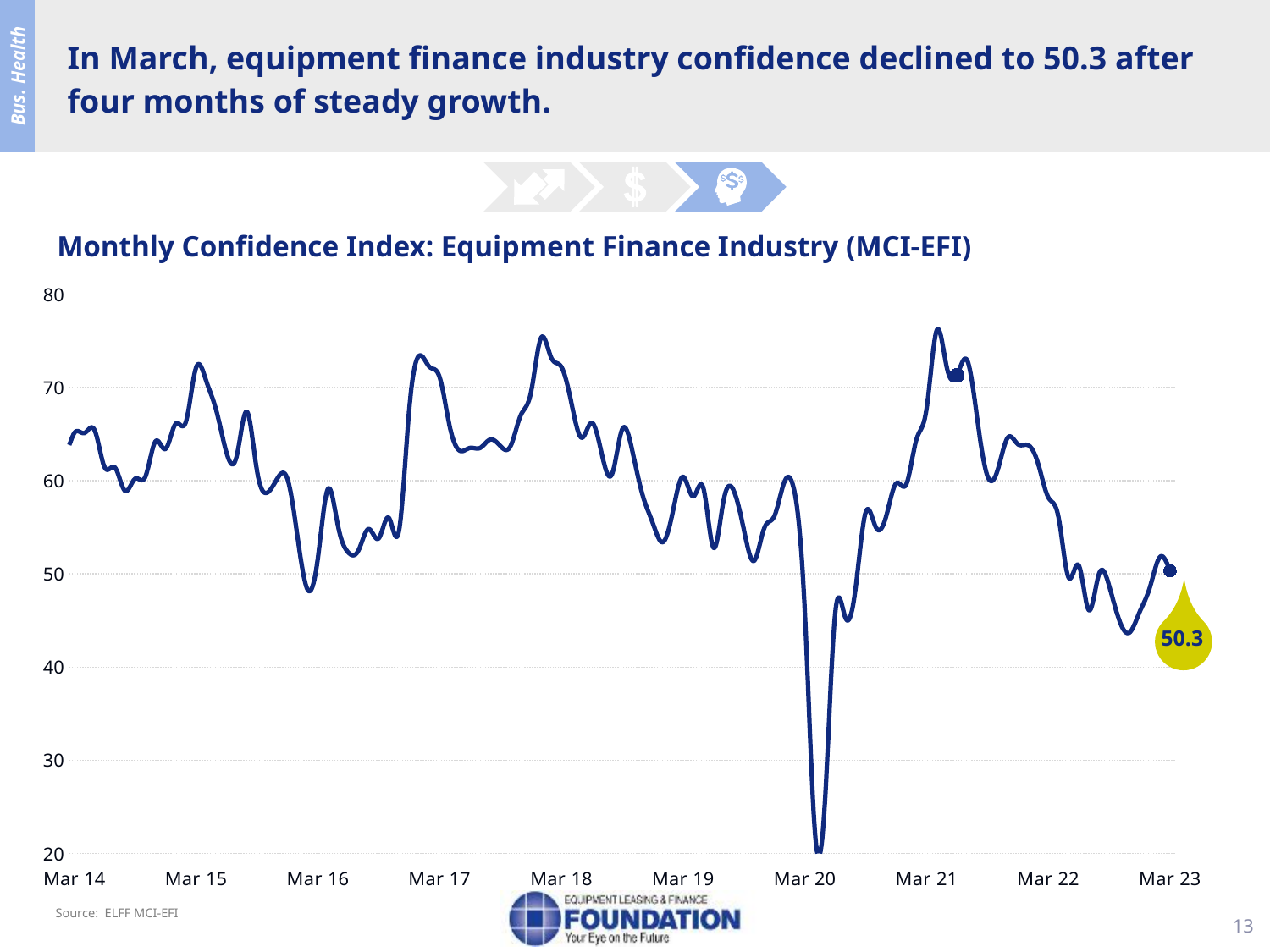
What is the title of the chart? Monthly Confidence Index: Equipment Finance Industry (MCI-EFI) What kind of chart is shown on the slide? line chart Which is higher, the index value at Mar 14 or at Mar 23? Mar 14 Does the index rise or fall overall from Mar 14 to Mar 23? fall Near which x-axis label does the line reach its lowest point? Mar 20 How many labels are shown on the x axis of the chart? 10 Is the value of the index at Mar 16 greater or less than 60? less Is the value of the index at Mar 15 greater or less than 70? greater What is the value of the Monthly Confidence Index at Mar 23? 50.3 What source is cited for the chart? ELFF MCI-EFI Is the lowest point of the line greater or less than 30? less